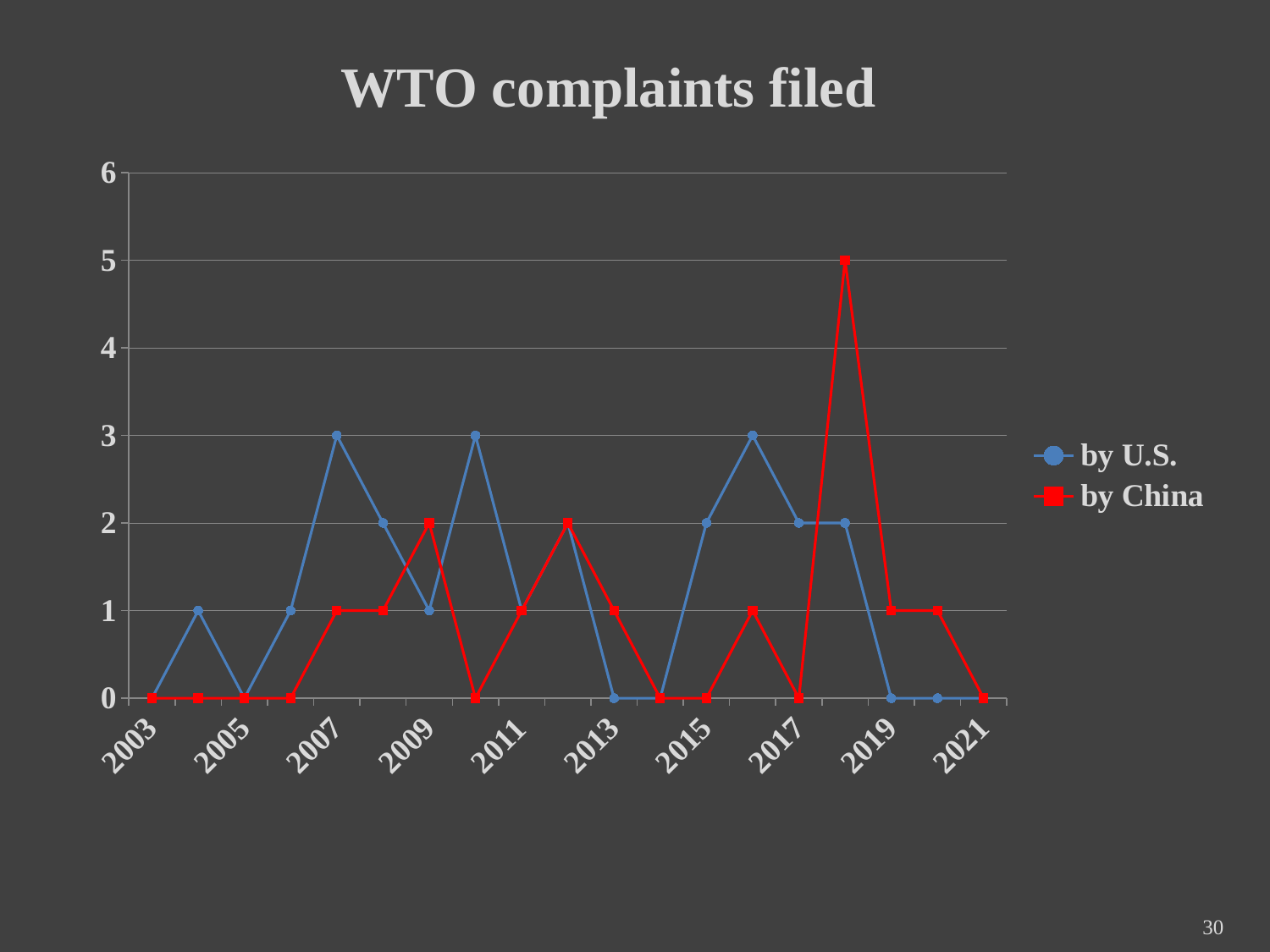
What is the value for 'by U.S.' in 2021? 0 In 2015, which series has the larger value, 'by U.S.' or 'by China'? by U.S. What is the difference between the 'by U.S.' and 'by China' values in 2007? 2 What is the value for 'by China' in 2019? 1 What is the value for 'by U.S.' in 2013? 0 In 2007, which series has the larger value, 'by U.S.' or 'by China'? by U.S. What is the highest value reached by the 'by China' series? 5 What kind of chart is shown on the slide? line chart What is the title of the chart? WTO complaints filed What is the value for 'by U.S.' in 2007? 3 How many series does the legend list? 2 What is the value for 'by China' in 2009? 2